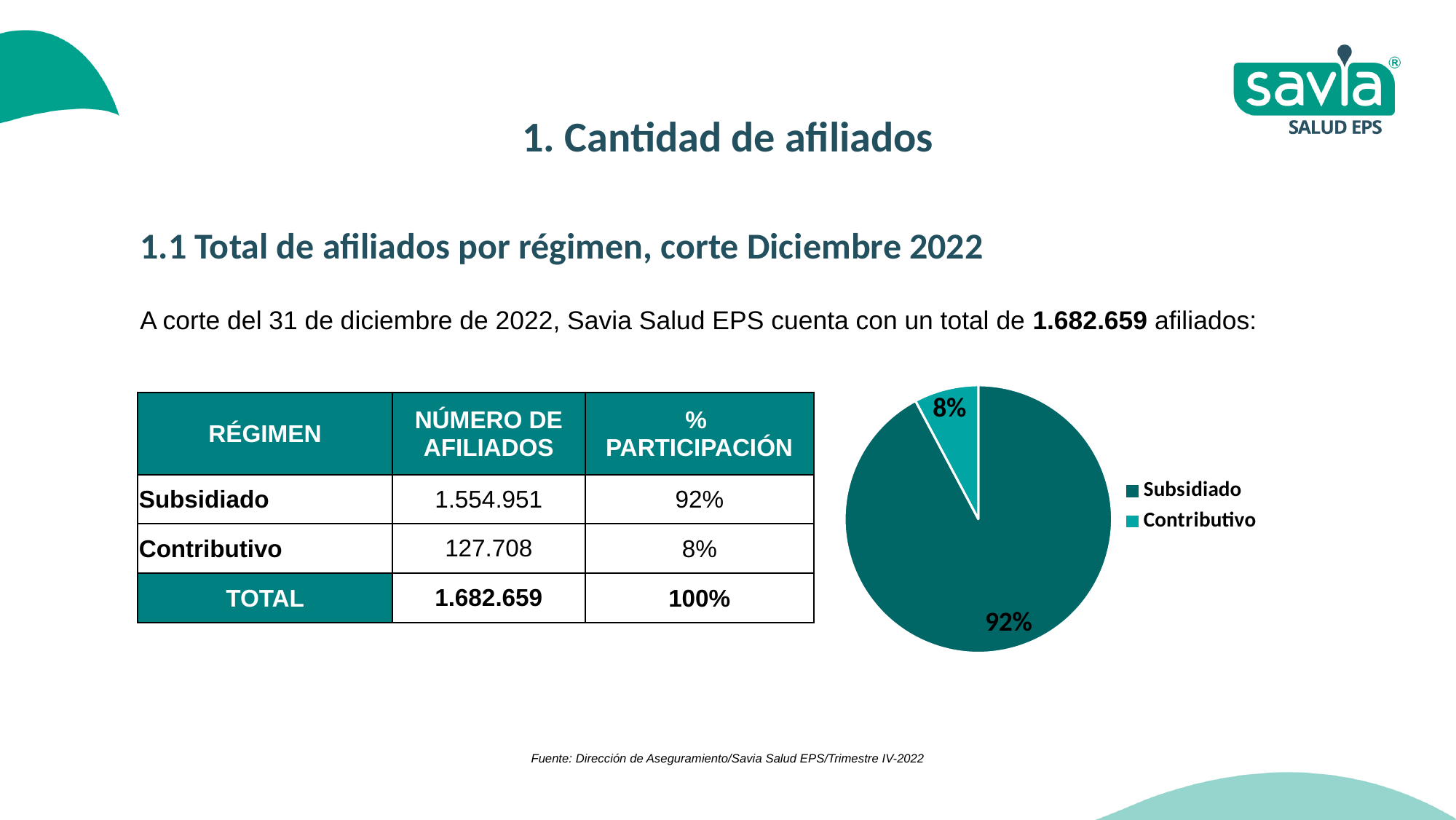
What is the total of the two percentages shown on the pie chart? 100% How many slices does the pie chart have? 2 What share of the pie does Contributivo represent? 8% What kind of chart is shown on the slide? pie chart What is the difference in percentage points between the Subsidiado and Contributivo slices? 84 Which is larger in the pie chart, Subsidiado or Contributivo? Subsidiado Which slice of the pie chart is the smallest? Contributivo Which legend entry is shown in the lighter teal colour? Contributivo How many entries does the legend of the pie chart list? 2 Which slice of the pie chart is the largest? Subsidiado What share of the pie does Subsidiado represent? 92%